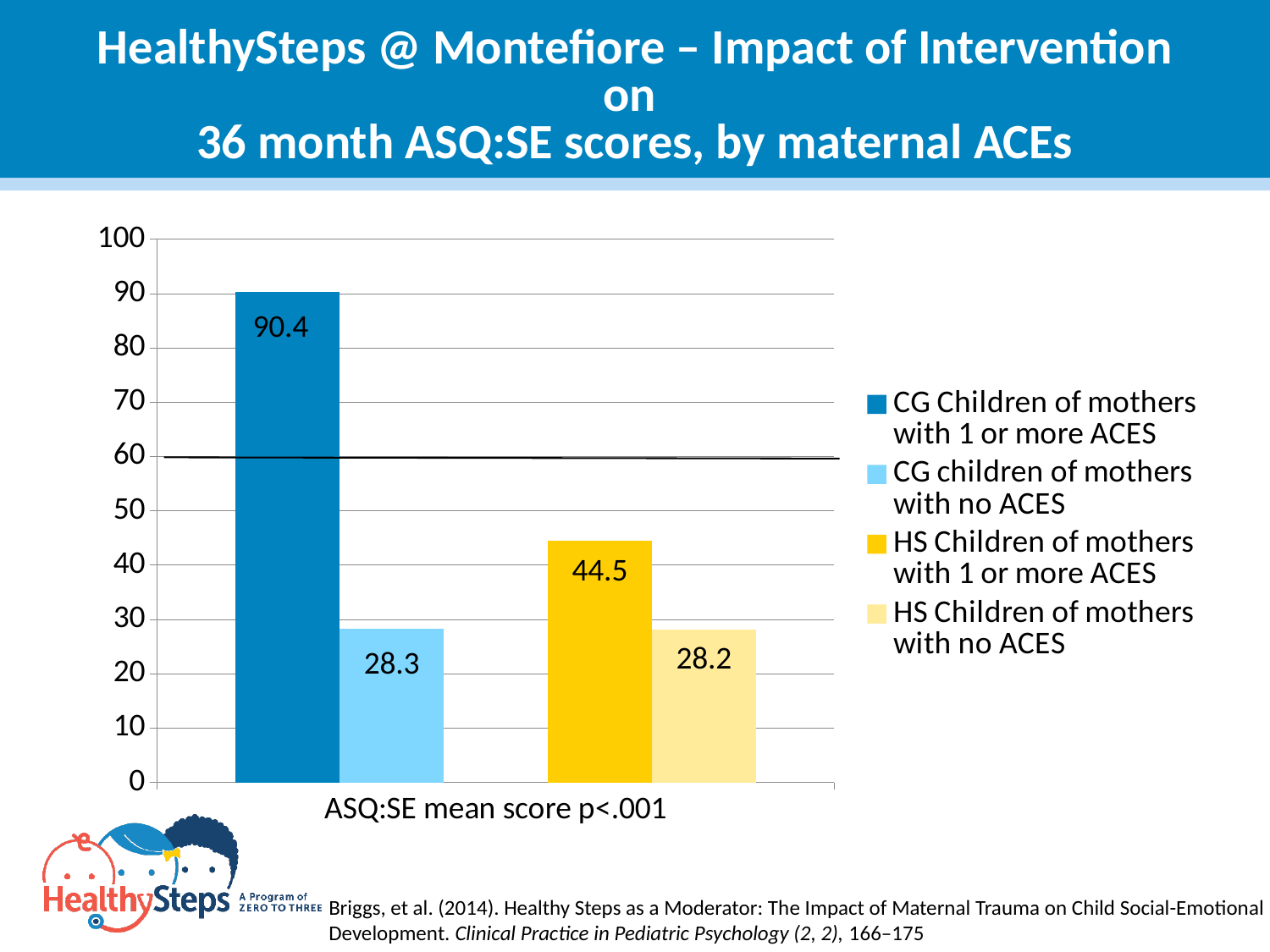
What is the label on the x axis of the chart? ASQ:SE mean score p<.001 What is the value for CG Children of mothers with 1 or more ACES? 90.4 Which is larger, the value for CG Children of mothers with 1 or more ACES or the value for HS Children of mothers with 1 or more ACES? CG Children of mothers with 1 or more ACES What is the value for HS Children of mothers with no ACES? 28.2 What is the value for HS Children of mothers with 1 or more ACES? 44.5 How many series does the legend list? 4 Is the value for HS Children of mothers with 1 or more ACES greater or less than 50? less What is the difference between the values for CG Children of mothers with 1 or more ACES and HS Children of mothers with 1 or more ACES? 45.9 Which series has the highest value? CG Children of mothers with 1 or more ACES What kind of chart is shown on the slide? bar chart What is the value for CG children of mothers with no ACES? 28.3 What is the difference between the values for HS Children of mothers with 1 or more ACES and HS Children of mothers with no ACES? 16.3